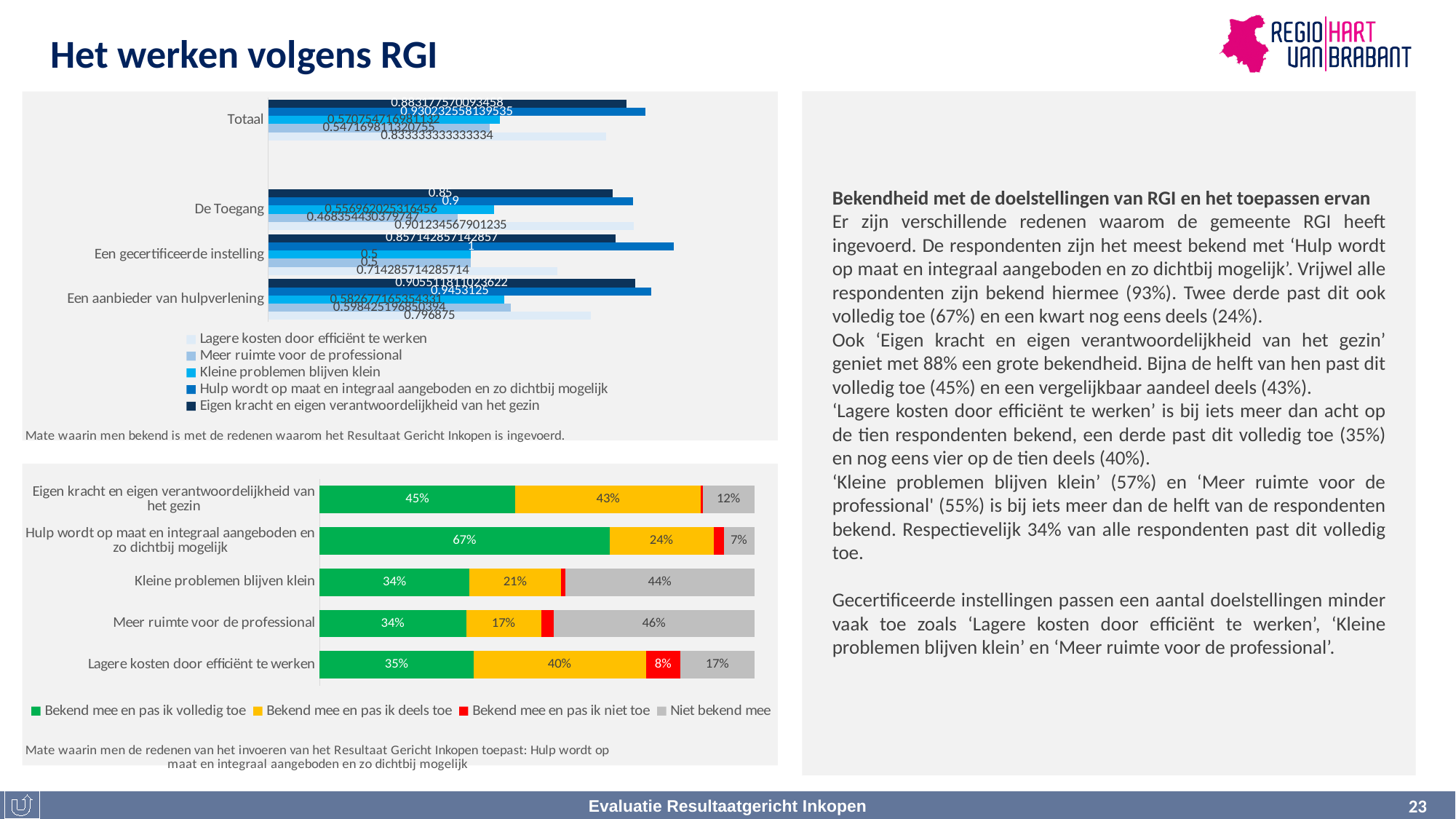
In the bottom chart, which category has the highest 'Bekend mee en pas ik volledig toe' share? Hulp wordt op maat en integraal aangeboden en zo dichtbij mogelijk In the bottom chart, what is the 'Niet bekend mee' value for 'Meer ruimte voor de professional'? 46% In the bottom chart, which is larger: the 'Bekend mee en pas ik deels toe' value for 'Eigen kracht en eigen verantwoordelijkheid van het gezin' or for 'Kleine problemen blijven klein'? Eigen kracht en eigen verantwoordelijkheid van het gezin In the bottom chart, which category has the lowest 'Niet bekend mee' share? Hulp wordt op maat en integraal aangeboden en zo dichtbij mogelijk How many series does the legend of the top chart list? 5 How many series does the legend of the bottom chart list? 4 What kind of chart is the bottom chart? Stacked bar chart In the bottom chart, what percentage of respondents chose 'Bekend mee en pas ik volledig toe' for 'Hulp wordt op maat en integraal aangeboden en zo dichtbij mogelijk'? 67% How many categories are shown in the bottom chart? 5 In the bottom chart, what is the difference in percentage points between the 'Bekend mee en pas ik volledig toe' values for 'Hulp wordt op maat en integraal aangeboden en zo dichtbij mogelijk' and 'Eigen kracht en eigen verantwoordelijkheid van het gezin'? 22 percentage points In the top chart, what is the value for 'Hulp wordt op maat en integraal aangeboden en zo dichtbij mogelijk' for 'Een gecertificeerde instelling'? 1 In the bottom chart, what is the 'Bekend mee en pas ik niet toe' value for 'Lagere kosten door efficiënt te werken'? 8%